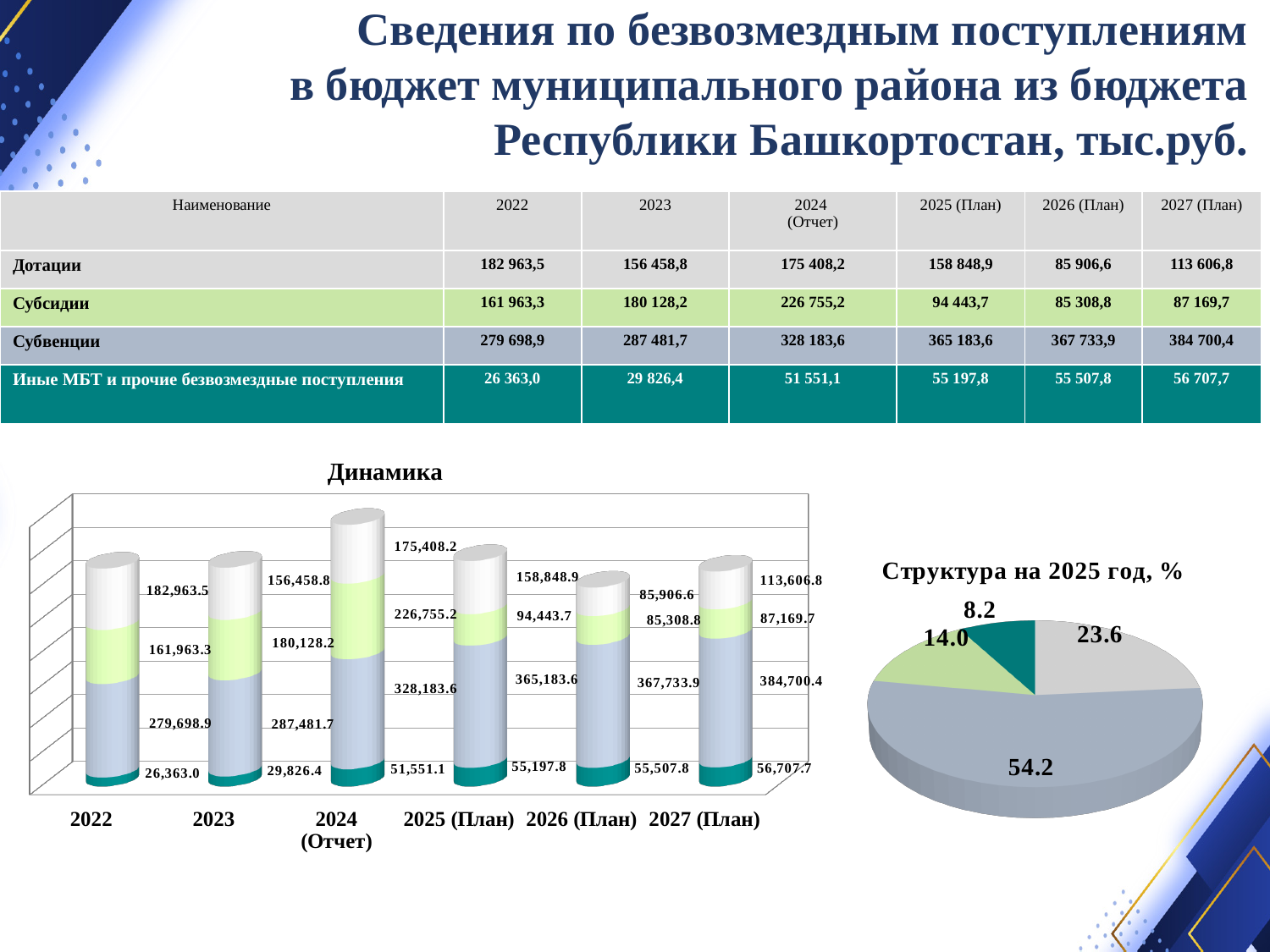
What kind of chart is the "Динамика" chart? bar chart In the "Динамика" chart, do the values of the bottom (teal) segment rise or fall from 2022 to 2027 (План)? rise In the "Динамика" chart, what is the value of the bottom (teal) segment for 2024 (Отчет)? 51,551.1 In the "Динамика" chart, what is the difference between the bottom (teal) segment values for 2027 (План) and 2026 (План)? 1,199.9 In the "Структура на 2025 год, %" chart, what is the share of the smallest slice? 8.2 In the "Динамика" chart, which year has the tallest stacked bar? 2024 (Отчет) What kind of chart is "Структура на 2025 год, %"? pie chart In the "Структура на 2025 год, %" chart, what is the share of the largest slice? 54.2 How many year categories are shown on the x axis of the "Динамика" chart? 6 In the "Динамика" chart, which is larger: the green segment for 2025 (План) or the green segment for 2026 (План)? 2025 (План) In the "Динамика" chart, what is the total of the stacked bar for 2022? 650,988.7 In the "Динамика" chart, what is the value of the top (white) segment for 2022? 182,963.5